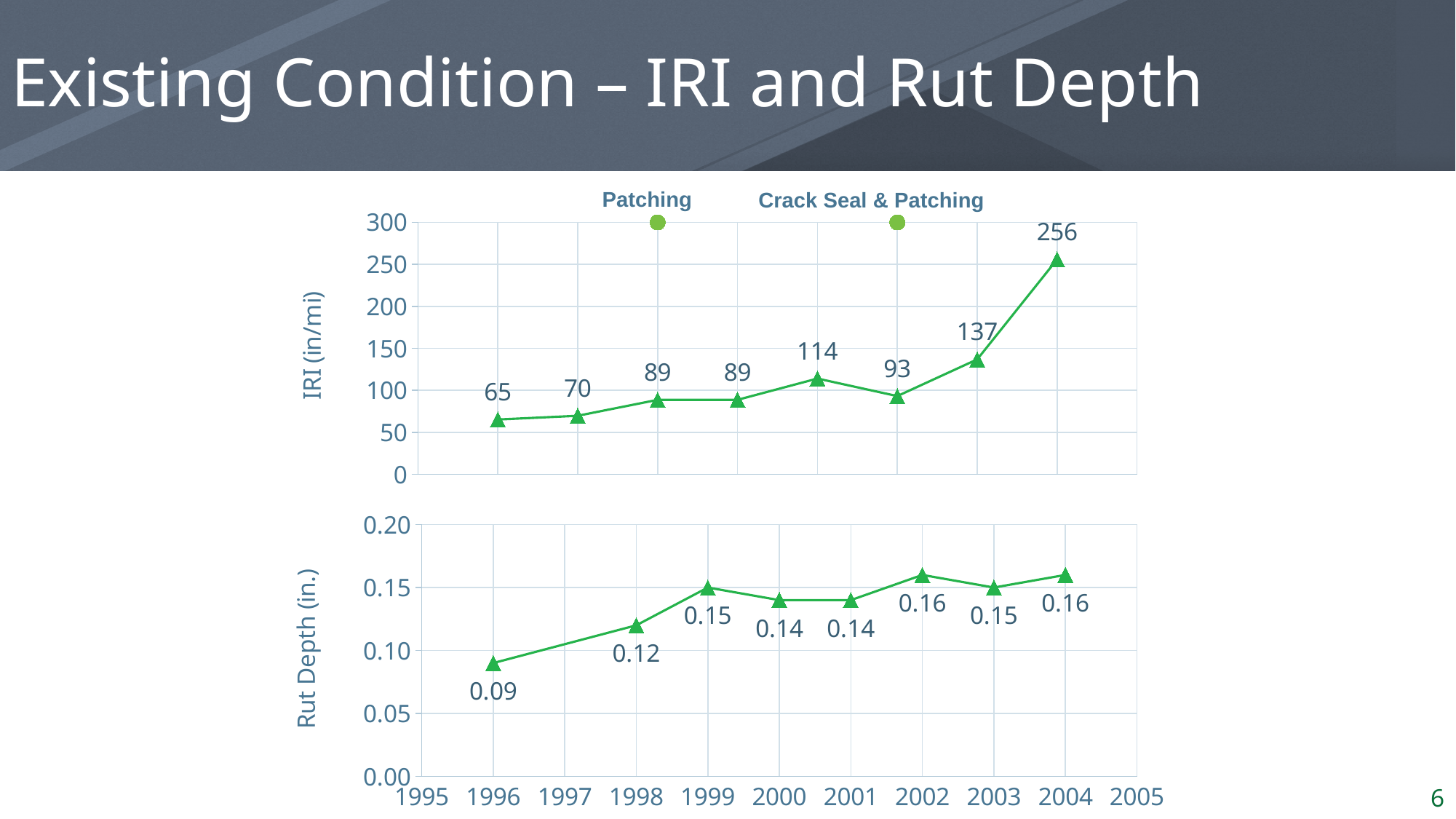
In the bottom Rut Depth chart, what is the difference between the rut depth in 2004 and in 1998? 0.04 What are the two maintenance events annotated above the top IRI chart? Patching; Crack Seal & Patching In the top IRI chart, what is the difference between the last data point (256) and the first data point (65)? 191 In the top IRI chart, what is the lowest IRI value shown? 65 In the bottom Rut Depth chart, is the rut depth for 2002 larger or smaller than for 2003? larger In the top IRI chart, what is the highest IRI value shown? 256 In the top IRI chart, what is the value of the data point immediately before the 137 point? 93 How many data points are plotted in the top IRI chart? 8 In the bottom Rut Depth chart, what is the rut depth for 1999? 0.15 What type of chart is the top chart (IRI)? line chart In the bottom Rut Depth chart, which year has the lowest rut depth? 1996 In the bottom Rut Depth chart, what is the rut depth for 1996? 0.09